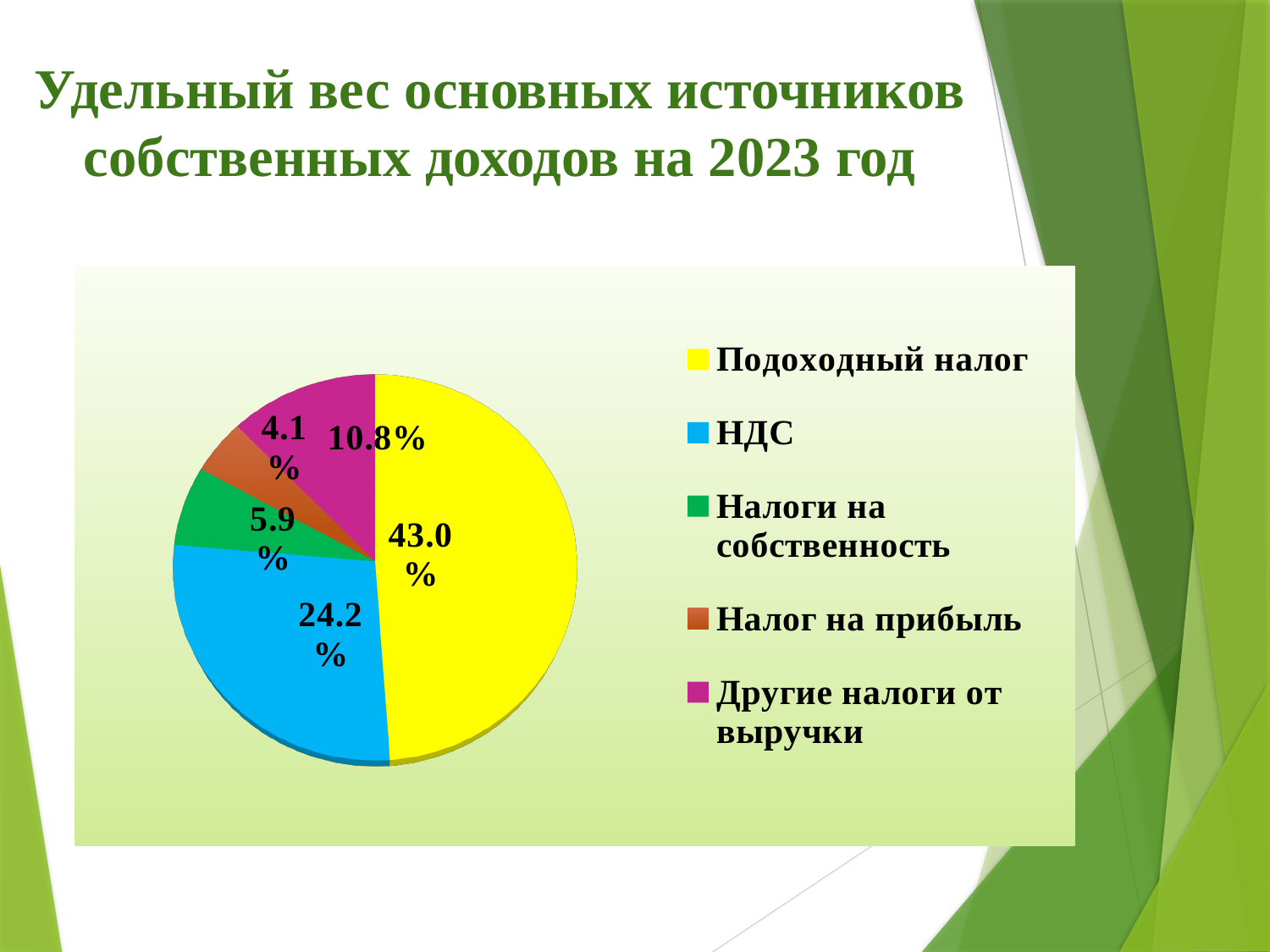
Which category has the largest share of the pie? Подоходный налог Which colour represents НДС in the pie chart? blue What is the value shown for НДС? 24.2% What is the value shown for Налоги на собственность? 5.9% How many categories does the pie chart have? 5 What is the difference between the shares of Подоходный налог and НДС? 18.8% What kind of chart is shown on the slide? pie chart Which is larger, the share of НДС or the share of Другие налоги от выручки? НДС What share of the pie does Подоходный налог have? 43.0% Which category has the smallest share of the pie? Налог на прибыль What is the value shown for Другие налоги от выручки? 10.8% What is the value shown for Налог на прибыль? 4.1%